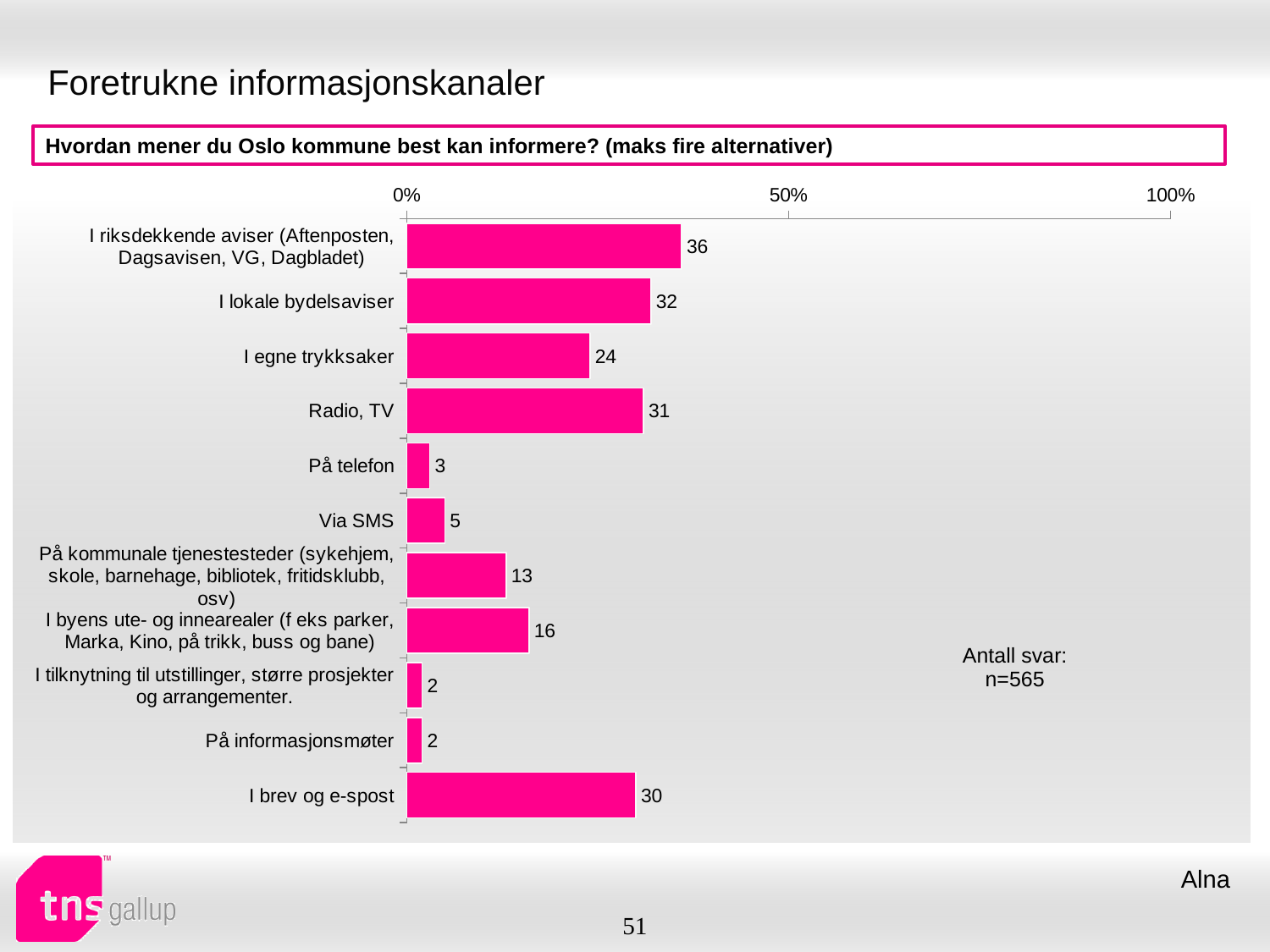
What kind of chart is shown on the slide? bar chart What is the value for "Via SMS"? 5 What is the value for "Radio, TV"? 31 What is the difference between the values for "I byens ute- og innearealer (f eks parker, Marka, Kino, på trikk, buss og bane)" and "På kommunale tjenestesteder (sykehjem, skole, barnehage, bibliotek, fritidsklubb, osv)"? 3 How many categories are shown in the chart? 11 What is the difference between the values for "I riksdekkende aviser (Aftenposten, Dagsavisen, VG, Dagbladet)" and "I egne trykksaker"? 12 What is the number of responses (n) stated on the slide? n=565 What is the value for "I brev og e-spost"? 30 Which category has the highest value? I riksdekkende aviser (Aftenposten, Dagsavisen, VG, Dagbladet) Which is larger, the value for "I lokale bydelsaviser" or the value for "Radio, TV"? I lokale bydelsaviser Is the value for "I riksdekkende aviser (Aftenposten, Dagsavisen, VG, Dagbladet)" greater or less than 50%? less What is the value for "I lokale bydelsaviser"? 32